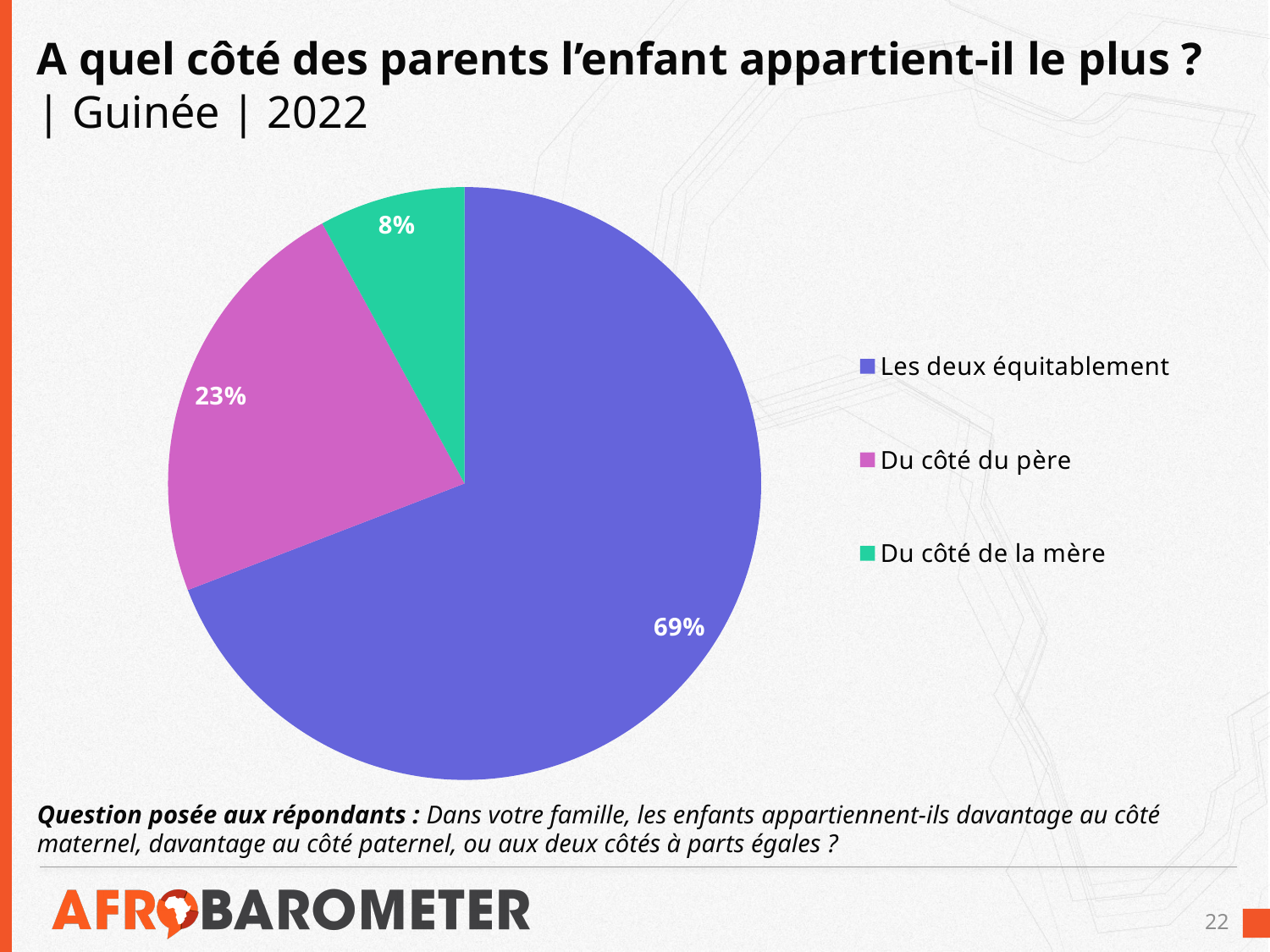
What percentage of respondents answered "Du côté du père"? 23% Which category has the largest share of the pie? Les deux équitablement Which colour represents "Du côté de la mère" in the pie chart? Green What percentage of respondents answered "Du côté de la mère"? 8% What type of chart is shown on the slide? Pie chart Which is larger: the share for "Du côté du père" or the share for "Du côté de la mère"? Du côté du père What percentage of respondents answered "Les deux équitablement"? 69% How many categories does the pie chart show? 3 Which category has the smallest share of the pie? Du côté de la mère What is the difference in percentage points between "Les deux équitablement" and "Du côté du père"? 46 percentage points Which country and year does the chart title refer to? Guinée, 2022 What is the difference in percentage points between "Du côté du père" and "Du côté de la mère"? 15 percentage points